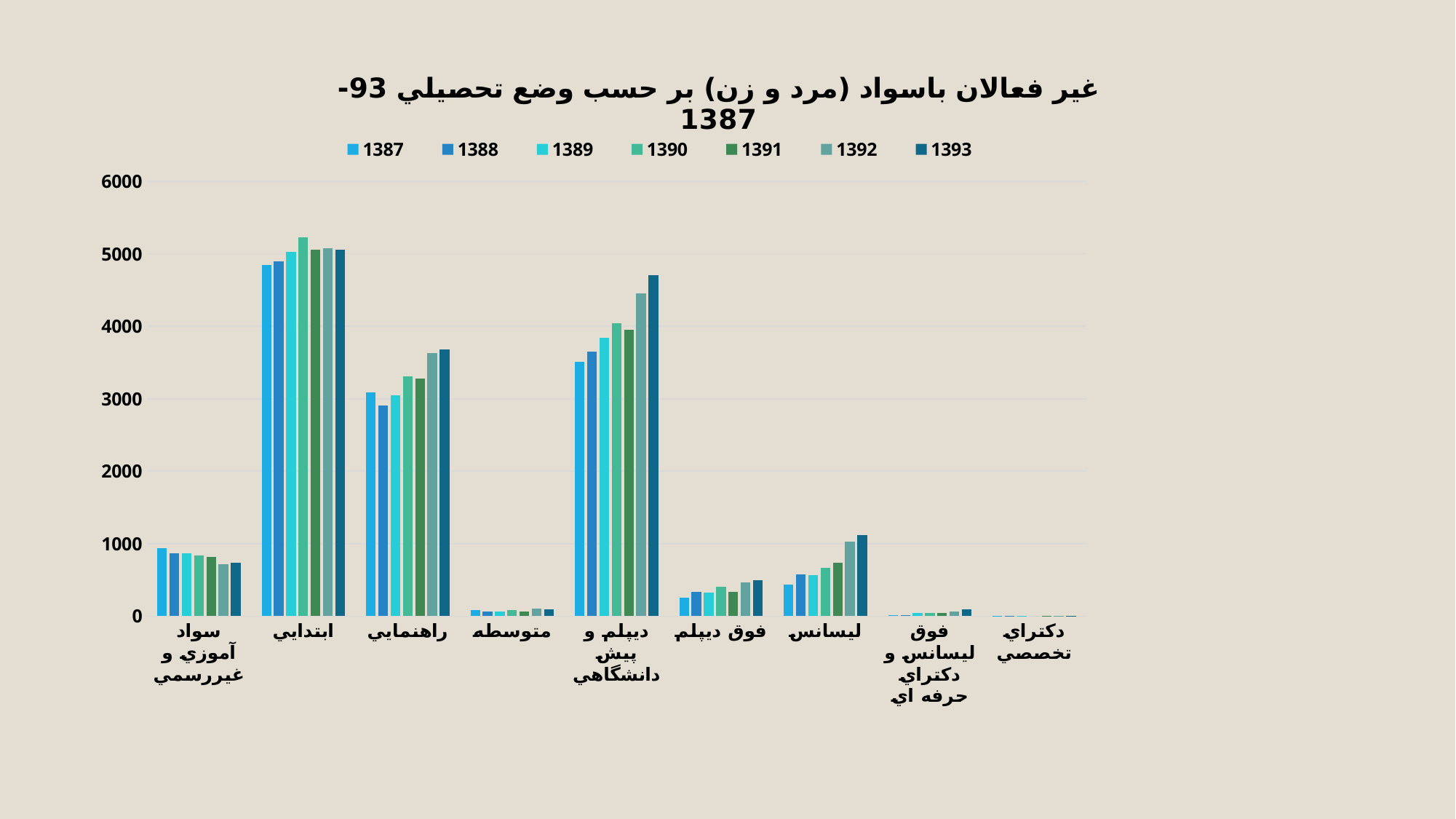
Which year is the first series listed in the legend? 1387 How many series does the legend list? 7 Is the value for ديپلم و پيش دانشگاهي in 1393 greater or less than 4000? greater Which education category has the highest bars overall? ابتدايي Is the value for ابتدايي in 1387 greater or less than 4000? greater How many education categories are shown on the x axis? 9 Is the value for راهنمايي in 1393 greater or less than 3000? greater Do the values for ليسانس rise or fall from 1387 to 1393? rise What kind of chart is shown on the slide? bar chart Which education category has the lowest bars overall? دكتراي تخصصي Which is larger in 1387: the value for ابتدايي or the value for ديپلم و پيش دانشگاهي? ابتدايي